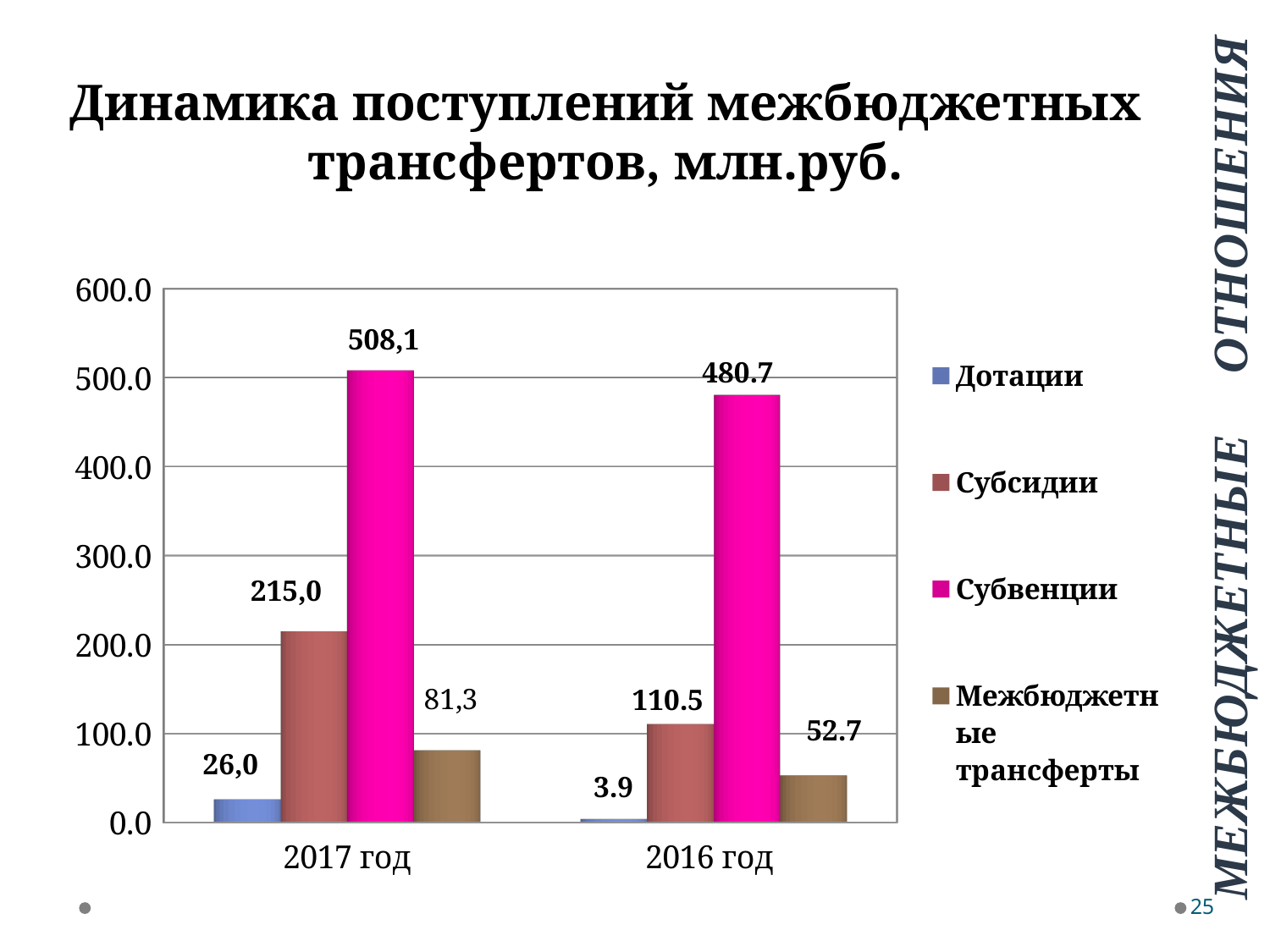
Which series has the highest value in 2016 год? Субвенции What is the value for Дотации in 2016 год? 3.9 What colour are the bars for Субвенции? magenta (pink) What is the difference between Субвенции and Субсидии in 2016 год? 370.2 What is the value for Межбюджетные трансферты in 2016 год? 52.7 Which is larger: Субсидии in 2017 год or Субсидии in 2016 год? Субсидии in 2017 год How many categories are shown on the x axis? 2 What is the value for Субвенции in 2017 год? 508,1 What type of chart is shown on the slide? bar chart How many series does the legend list? 4 Which series has the lowest value in 2017 год? Дотации What is the value for Субсидии in 2017 год? 215,0